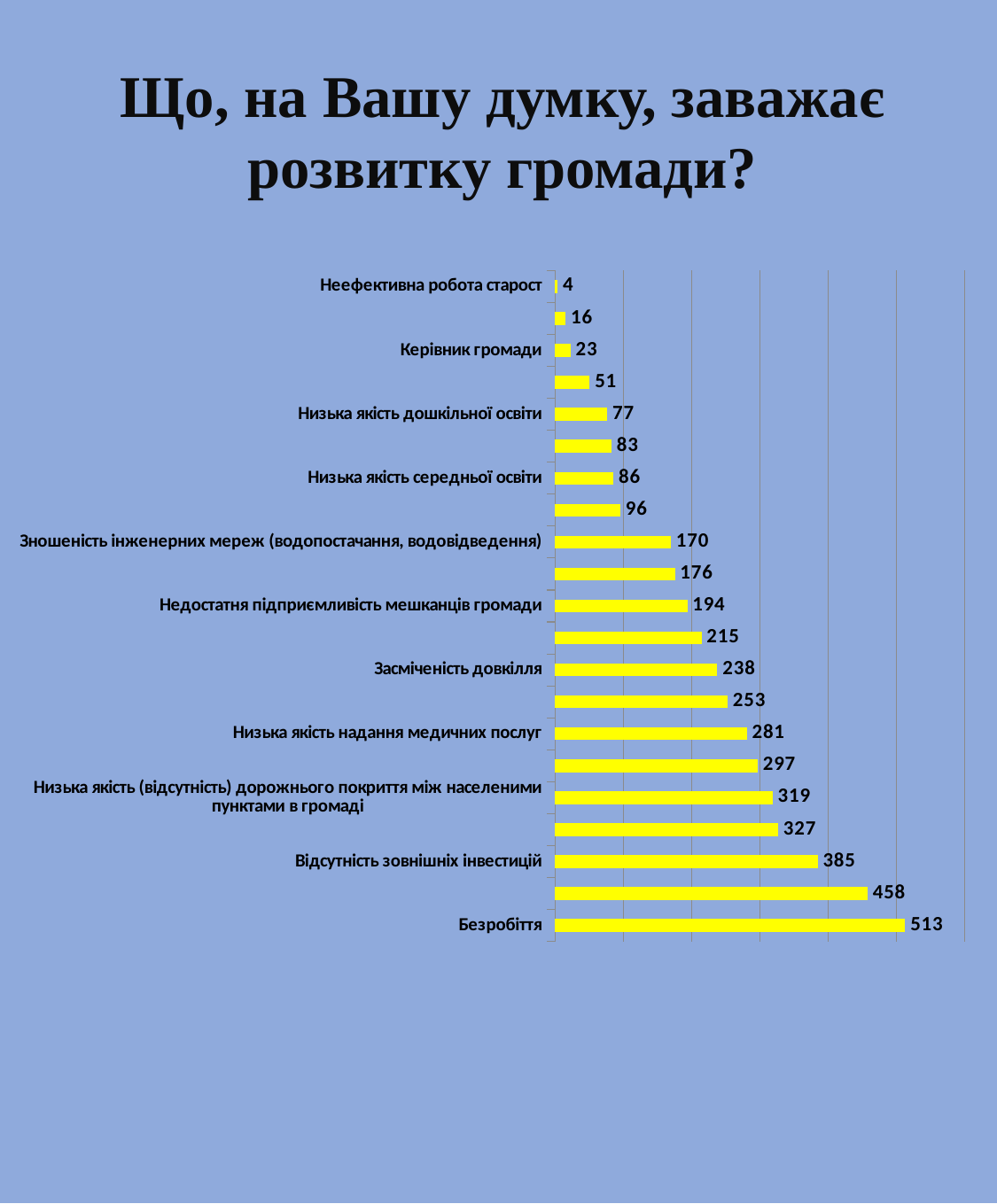
How many bars are plotted in the chart? 21 Which is larger: the value for Низька якість середньої освіти or the value for Низька якість дошкільної освіти? Низька якість середньої освіти What is the difference between the values for Безробіття and Відсутність зовнішніх інвестицій? 128 Which category has the lowest value? Неефективна робота старост What is the value for Безробіття? 513 What is the value for Засміченість довкілля? 238 What is the value for Низька якість надання медичних послуг? 281 What kind of chart is shown on the slide? bar chart What colour are the bars in the chart? yellow What is the value for Неефективна робота старост? 4 Which category has the highest value? Безробіття What is the value for Відсутність зовнішніх інвестицій? 385